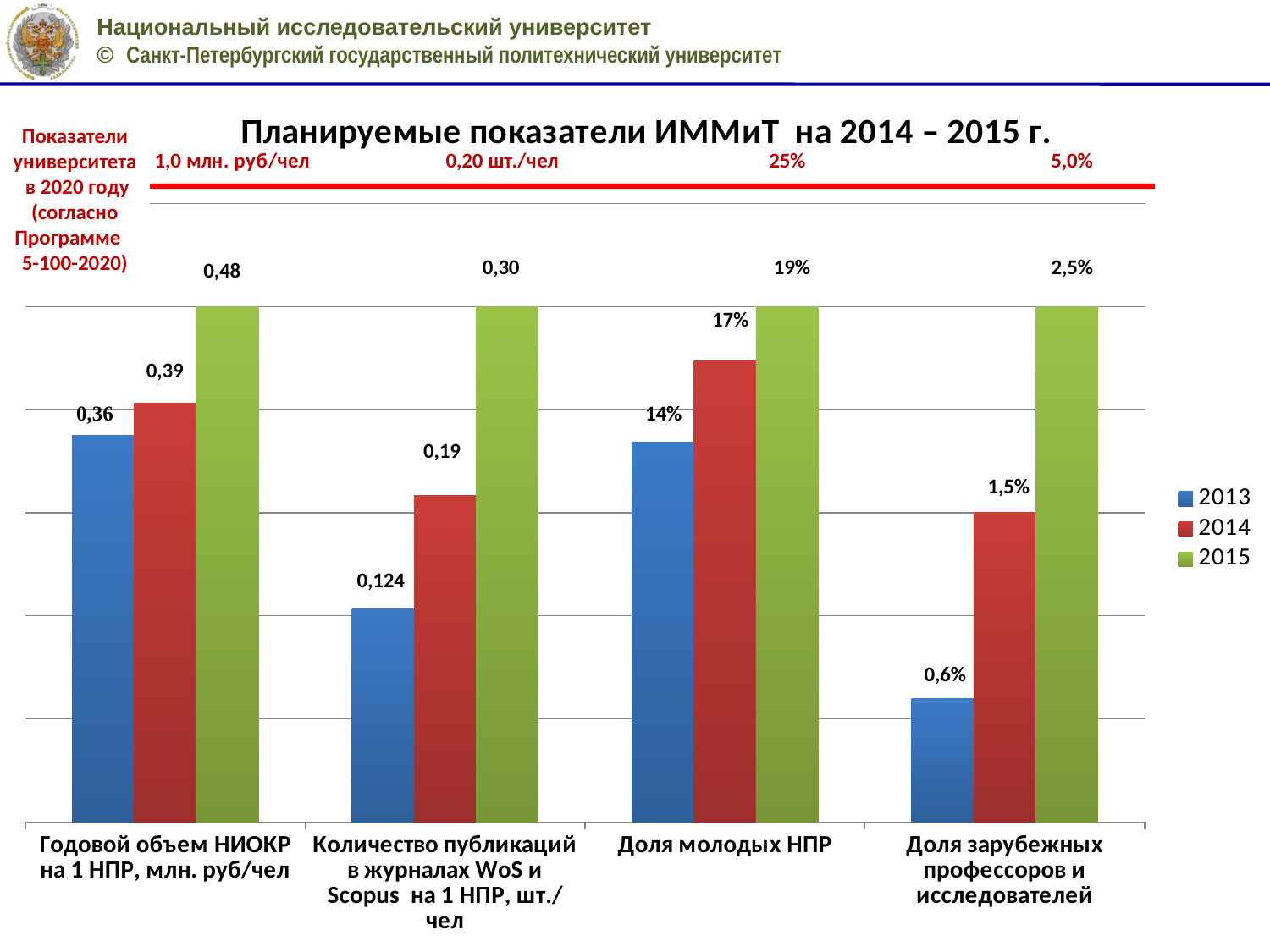
What is the 2014 value for "Доля молодых НПР"? 17% Which is larger for "Годовой объем НИОКР на 1 НПР, млн. руб/чел": the 2014 value or the 2015 value? 2015 What is the 2013 value for "Годовой объем НИОКР на 1 НПР, млн. руб/чел"? 0,36 Which year has the highest value for "Доля зарубежных профессоров и исследователей"? 2015 What type of chart is shown on the slide? bar chart How many series does the legend list? 3 What is the difference between the 2015 and 2013 values for "Доля молодых НПР"? 5% Which year has the lowest value for "Количество публикаций в журналах WoS и Scopus на 1 НПР, шт./чел"? 2013 What is the 2015 value for "Количество публикаций в журналах WoS и Scopus на 1 НПР, шт./чел"? 0,30 What is the 2013 value for "Доля зарубежных профессоров и исследователей"? 0,6% How many categories are shown on the x axis of the chart? 4 What is the title of the chart? Планируемые показатели ИММиТ на 2014 – 2015 г.